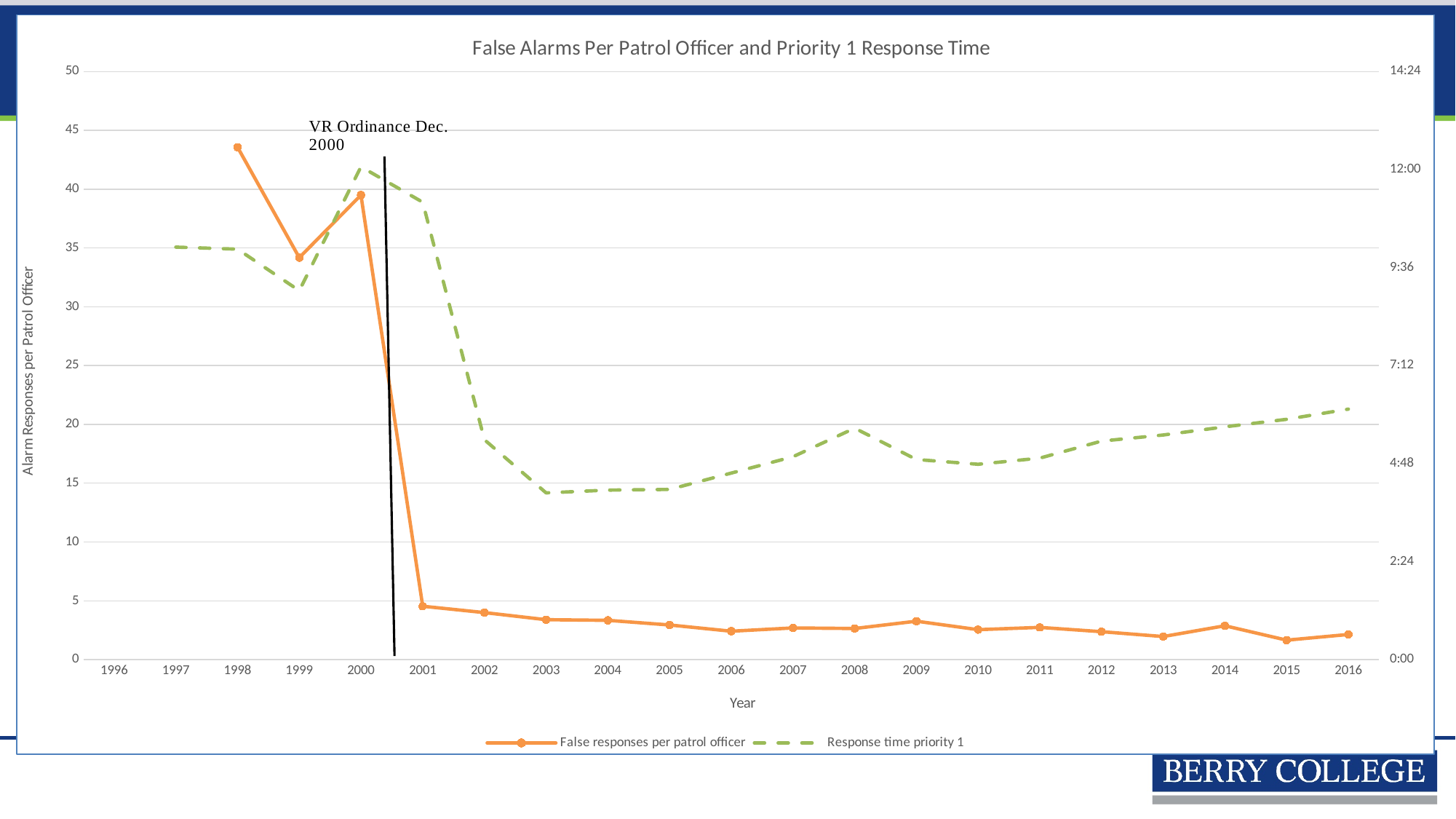
Is the value for Response time priority 1 in 2003 greater or less than 4:48? less In which year is the value for False responses per patrol officer highest? 1998 How many years are labelled on the x axis? 21 In which year is the value for Response time priority 1 highest? 2000 What kind of chart is shown on the slide? line chart Is the value for False responses per patrol officer in 1998 greater or less than 40? greater How many series does the legend list? 2 Is the value for False responses per patrol officer in 2001 greater or less than 10? less What is the title of the chart? False Alarms Per Patrol Officer and Priority 1 Response Time Does the Response time priority 1 series rise or fall from 2010 to 2016? rise Which is larger, the value for False responses per patrol officer in 1998 or in 2000? 1998 What annotation is written next to the vertical black line on the chart? VR Ordinance Dec. 2000